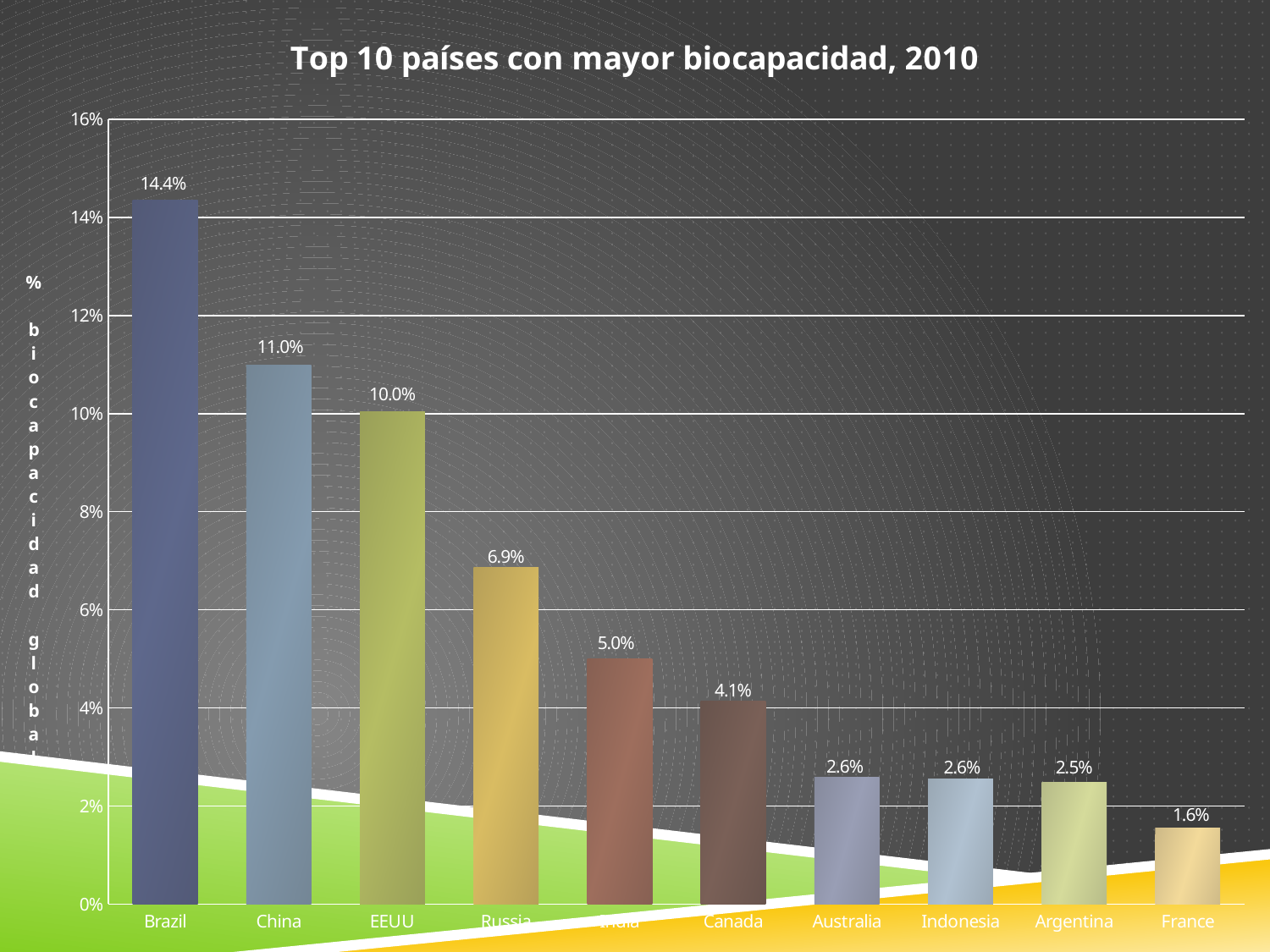
What is the value for France? 1.6% Which is larger, the value for EEUU or the value for Russia? EEUU How many countries are shown in the chart? 10 Which country has the lowest biocapacity share? France What is the title of the chart? Top 10 países con mayor biocapacidad, 2010 What is the value for Brazil? 14.4% What is the value for Canada? 4.1% What is the difference between the values for Brazil and China? 3.4% What is the value for China? 11.0% Is the value for Australia greater or less than 4%? less Which country has the highest biocapacity share? Brazil What kind of chart is shown on the slide? bar chart